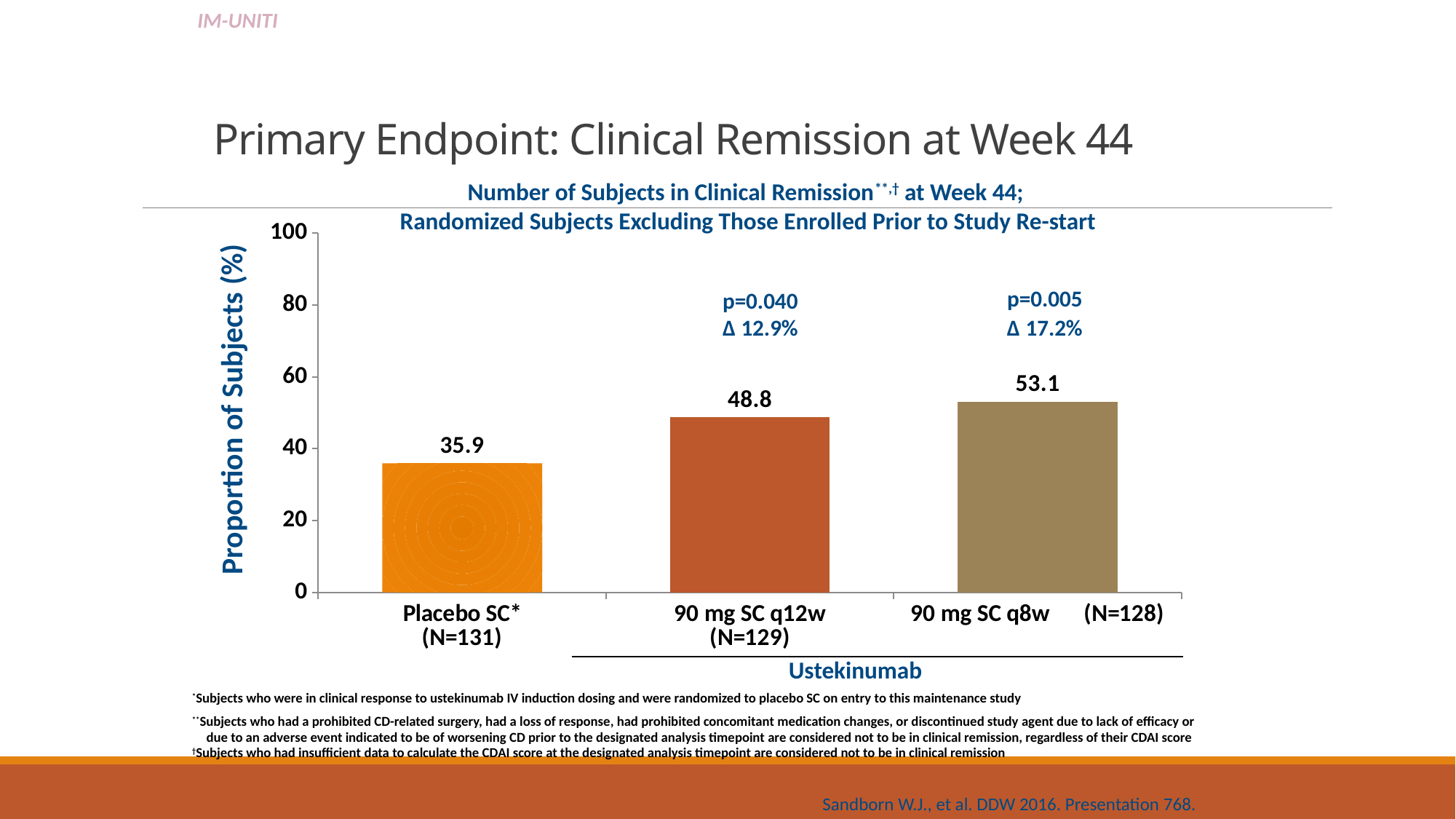
Which is larger, the value for 90 mg SC q12w or the value for Placebo SC? 90 mg SC q12w What is the label of the y axis? Proportion of Subjects (%) What is the difference between the values for 90 mg SC q12w and Placebo SC? 12.9 What is the value for Placebo SC? 35.9 How many bars are shown in the chart? 3 Which group has the lowest proportion of subjects in clinical remission? Placebo SC What is the value for 90 mg SC q8w? 53.1 What kind of chart is shown on the slide? bar chart What is the value for 90 mg SC q12w? 48.8 What is the difference between the values for 90 mg SC q8w and Placebo SC? 17.2 Is the value for Placebo SC greater or less than 40? less Which group has the highest proportion of subjects in clinical remission? 90 mg SC q8w